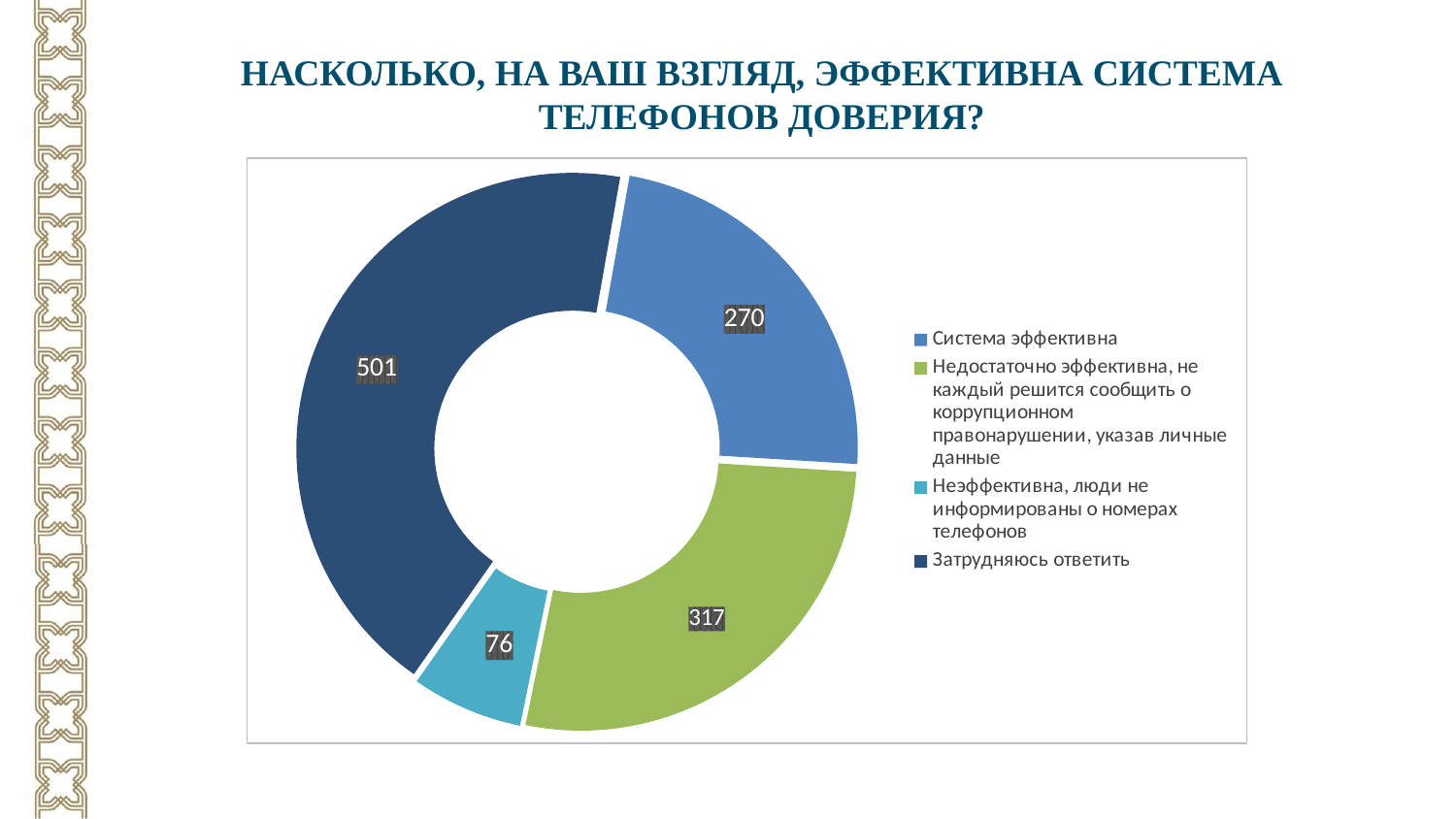
What colour is the slice for "Затрудняюсь ответить"? dark blue What is the difference between the values for "Затрудняюсь ответить" and "Система эффективна"? 231 How many categories does the chart show? 4 What is the total of all values shown in the chart? 1164 What is the value for "Затрудняюсь ответить"? 501 Which category has the smallest value? Неэффективна, люди не информированы о номерах телефонов How many respondents answered "Система эффективна"? 270 Which category has the largest value? Затрудняюсь ответить What is the value for the category "Неэффективна, люди не информированы о номерах телефонов"? 76 Which is larger: the value for "Система эффективна" or the value for "Недостаточно эффективна..."? Недостаточно эффективна... What is the value for "Недостаточно эффективна, не каждый решится сообщить о коррупционном правонарушении, указав личные данные"? 317 What type of chart is shown on the slide? doughnut chart